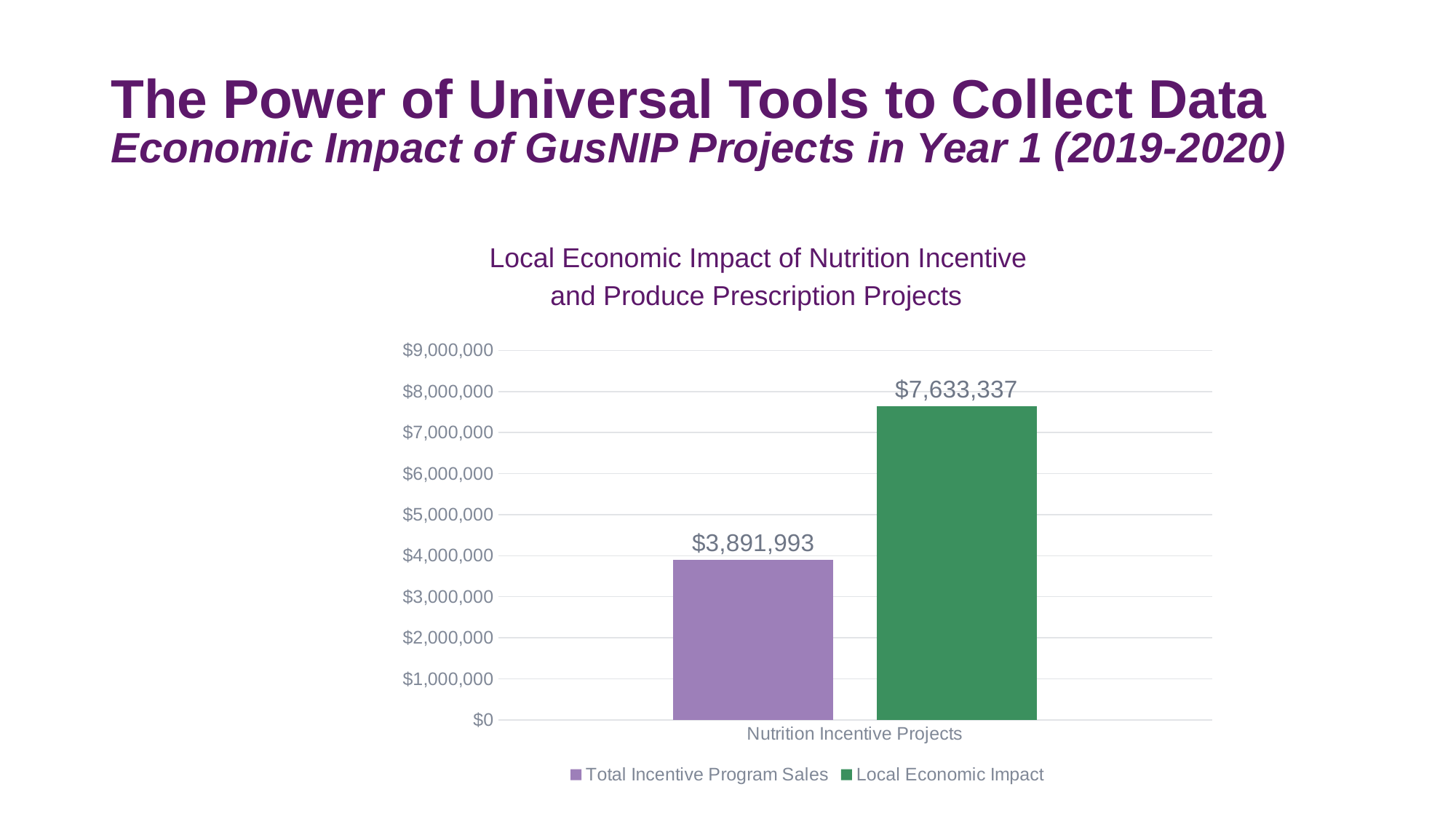
How many series does the legend list? 2 Which series has the higher value: Total Incentive Program Sales or Local Economic Impact? Local Economic Impact How many categories are shown on the x axis? 1 What is the difference between Local Economic Impact and Total Incentive Program Sales? $3,741,344 Is the value for Local Economic Impact greater or less than $7,000,000? greater What kind of chart is shown on the slide? Bar chart What is the title of the chart? Local Economic Impact of Nutrition Incentive and Produce Prescription Projects Which series has the lowest value on the chart? Total Incentive Program Sales Is the value for Total Incentive Program Sales greater or less than $4,000,000? less Which series has the highest value on the chart? Local Economic Impact What is the value of Total Incentive Program Sales for Nutrition Incentive Projects? $3,891,993 What is the value of Local Economic Impact for Nutrition Incentive Projects? $7,633,337